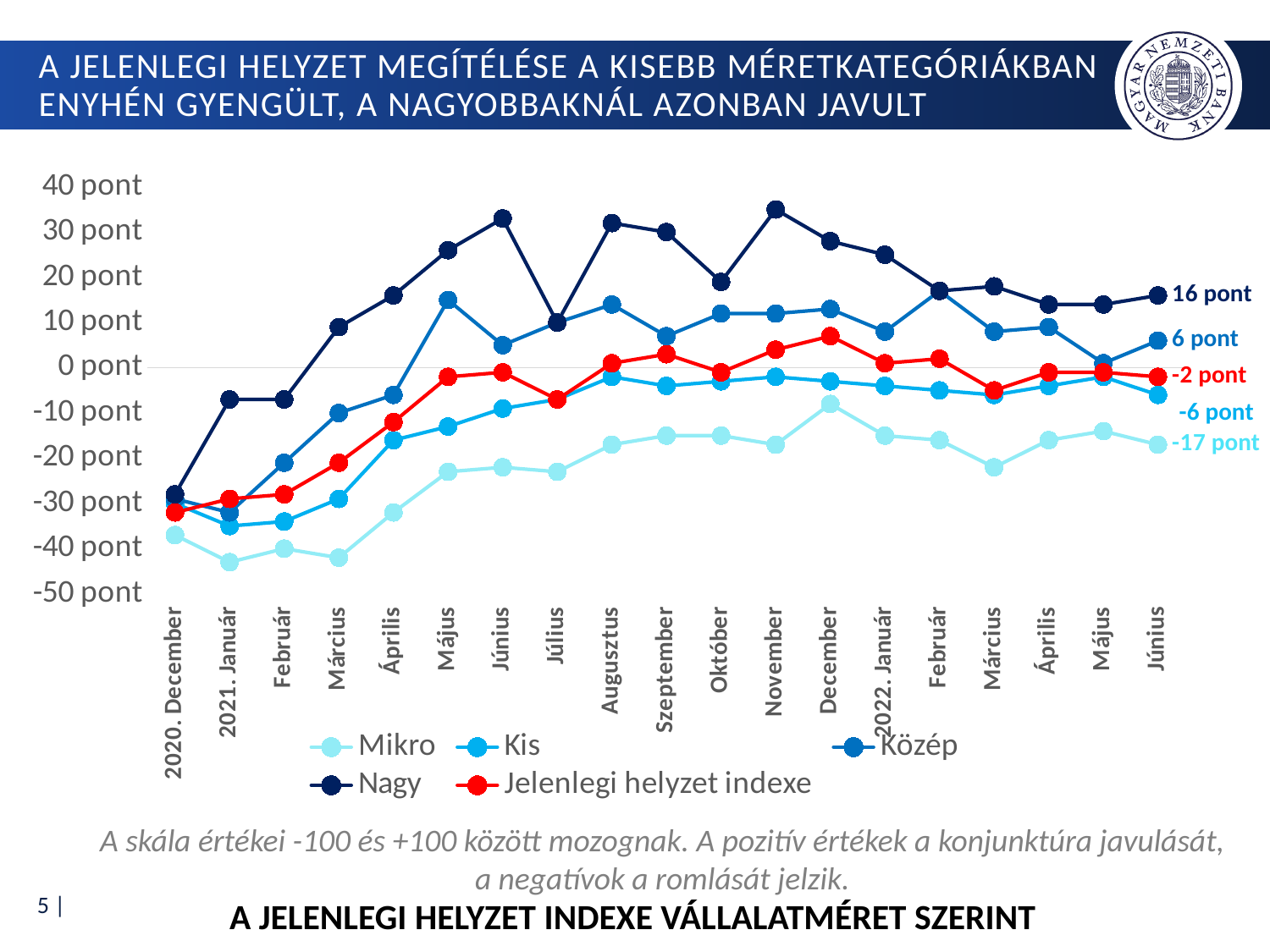
Is the value of the Mikro series in 2021 Január greater or less than -40 pont? less Which series has the highest value in 2022 Június? Nagy What is the value of the Jelenlegi helyzet indexe series in 2022 Június? -2 pont What is the value of the Nagy series in 2022 Június? 16 pont Is the value of the Nagy series in 2021 November greater or less than 30 pont? greater What is the value of the Mikro series in 2022 Június? -17 pont How many series does the legend list? 5 What is the difference between the Közép and Kis values in 2022 Június? 12 pont What type of chart is shown on the slide? line chart Which series has the lowest value in 2022 Június? Mikro How many months are shown along the x axis? 19 Does the Nagy series rise or fall from 2020 December to 2021 Június? rise